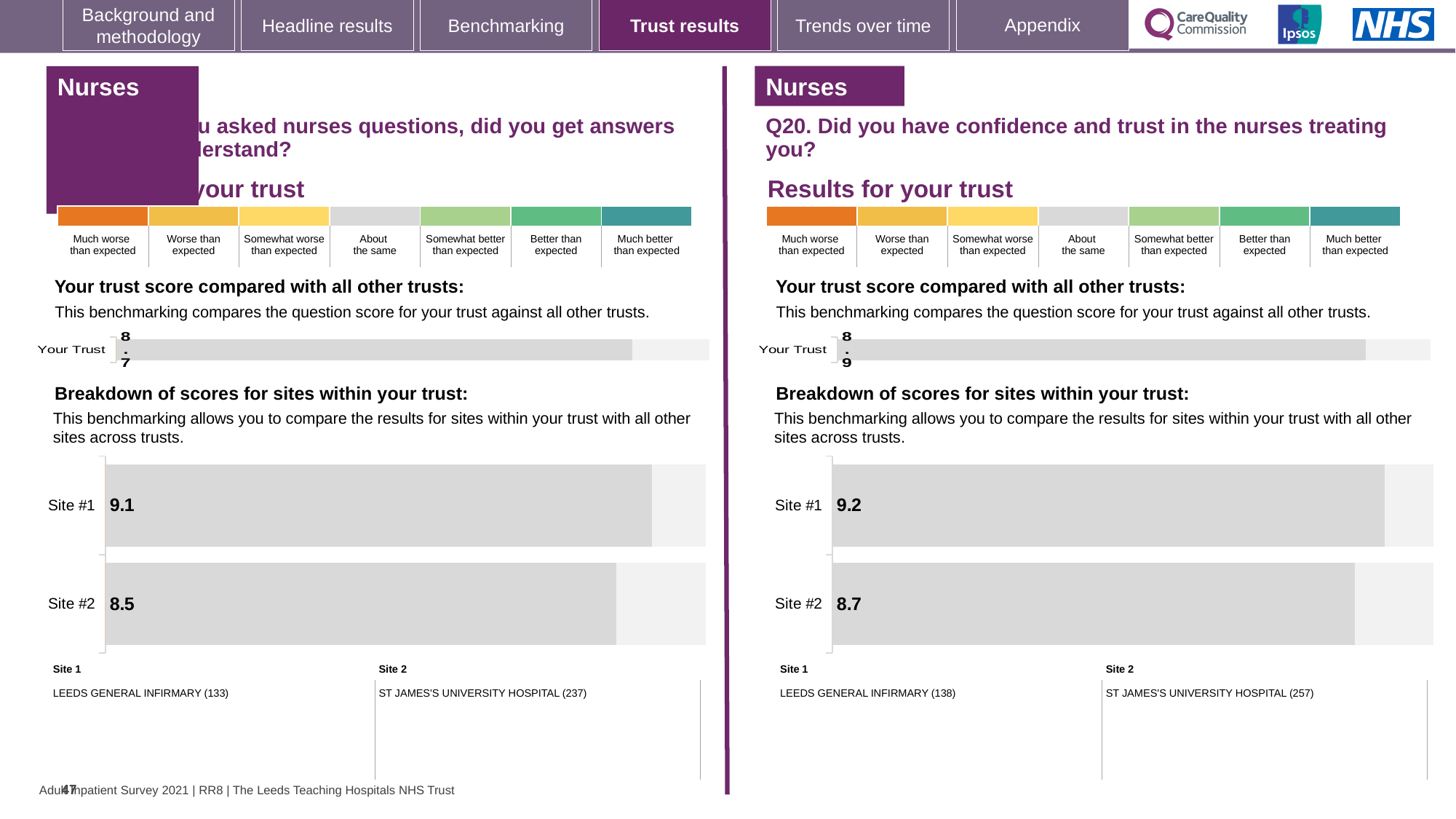
On the right-hand panel (Q20) site breakdown chart, which site has the lower score? Site #2 How many sites are shown in the site breakdown chart on the right-hand panel (Q20)? 2 On the left-hand panel's site breakdown chart, what is the score for Site #1? 9.1 On the right-hand panel (Q20, confidence and trust in nurses), what is the score for Site #1? 9.2 On the left-hand panel's site breakdown chart, what is the difference between the Site #1 and Site #2 scores? 0.6 On the left-hand panel's site breakdown chart, which site has the higher score? Site #1 On the left-hand panel's 'Your trust score compared with all other trusts' chart, what is the score for Your Trust? 8.7 On the right-hand panel (Q20) site breakdown chart, what is the difference between the Site #1 and Site #2 scores? 0.5 On the left-hand panel's site breakdown chart, what is the score for Site #2? 8.5 What type of chart is used for the site breakdown on the left-hand panel? Bar chart On the right-hand panel (Q20), what is the score for Your Trust in the 'Your trust score compared with all other trusts' chart? 8.9 On the right-hand panel (Q20, confidence and trust in nurses), what is the score for Site #2? 8.7